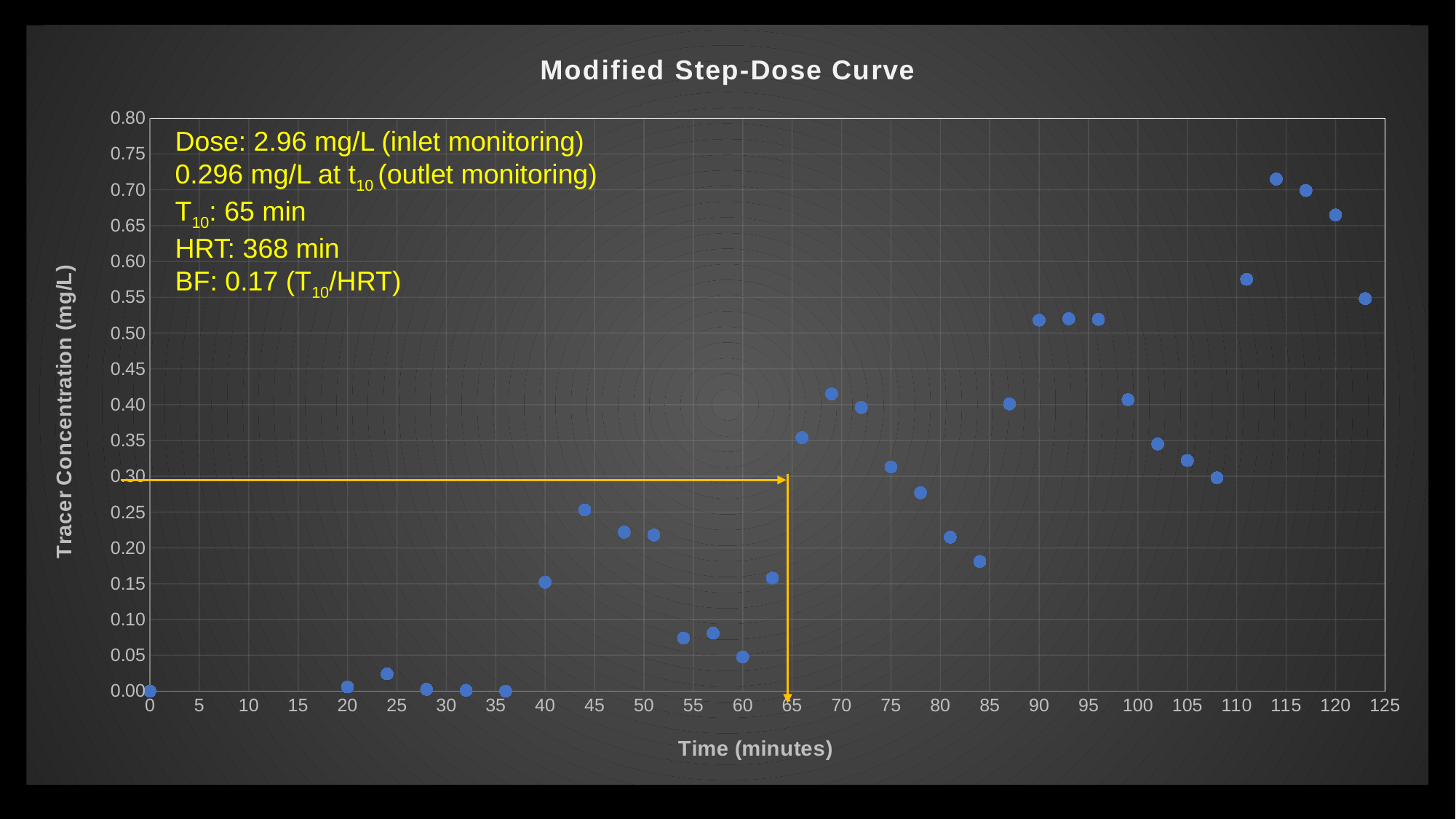
What kind of chart is shown on the slide? scatter chart Do the tracer concentration values rise or fall between 99 and 108 minutes? fall What is the label of the vertical axis? Tracer Concentration (mg/L) Which has the higher tracer concentration: the point at 69 minutes or the point at 60 minutes? 69 minutes Is the tracer concentration at 90 minutes greater or less than 0.45? greater What is the title of the chart? Modified Step-Dose Curve Is the tracer concentration at 84 minutes greater or less than 0.25? less Is the tracer concentration at 40 minutes greater or less than 0.20? less Do the tracer concentration values rise or fall between 20 and 44 minutes? rise